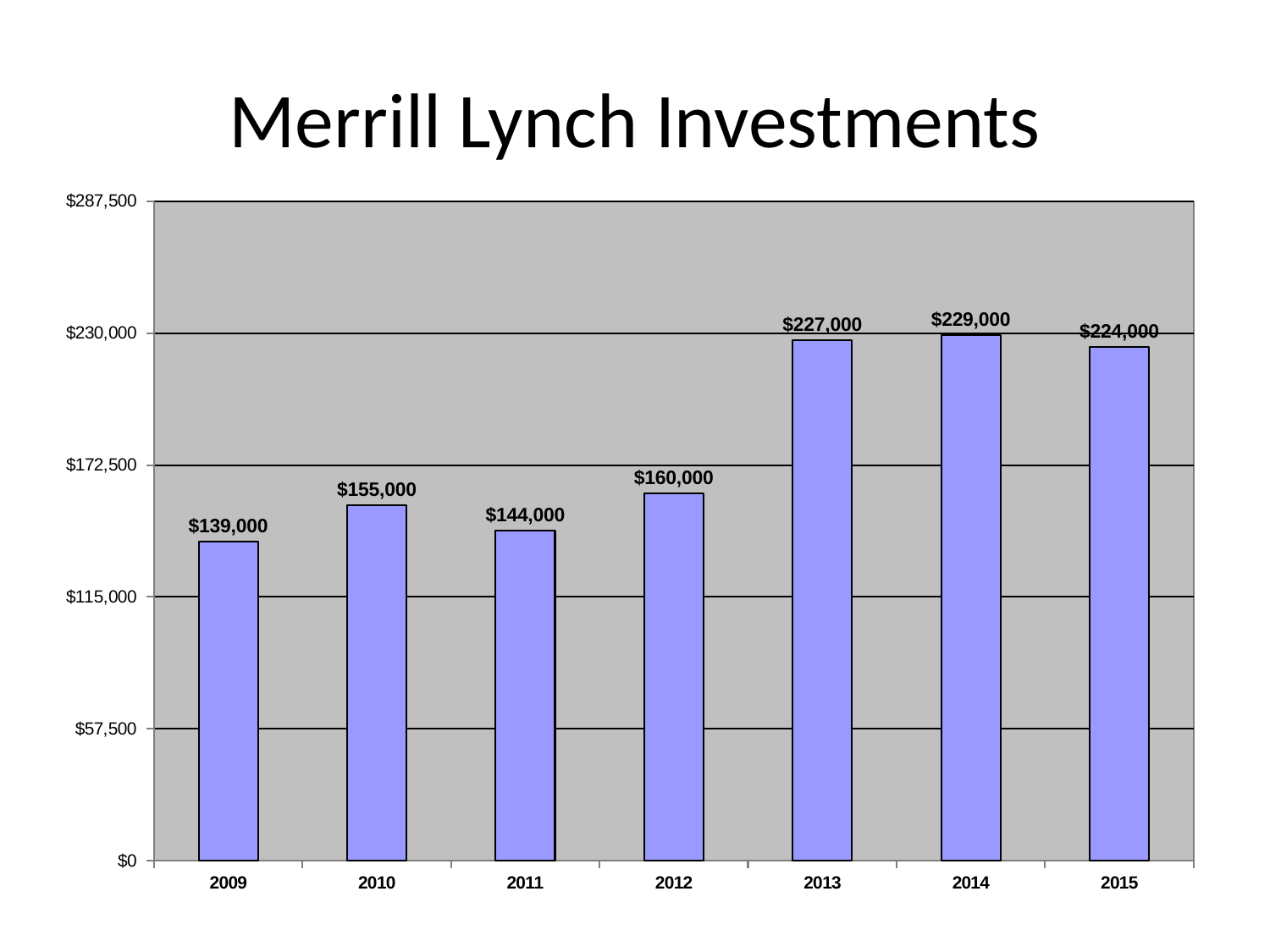
Which is larger, the value for 2010 or the value for 2011? 2010 What kind of chart is shown on the slide? bar chart Which year has the lowest value? 2009 How many years are shown on the chart? 7 Which year has the highest value? 2014 What is the difference between the values for 2014 and 2009? $90,000 What is the value for 2009? $139,000 Is the value for 2012 greater or less than $172,500? less What is the title of the chart? Merrill Lynch Investments What is the value for 2015? $224,000 What is the difference between the values for 2012 and 2011? $16,000 What is the value for 2013? $227,000